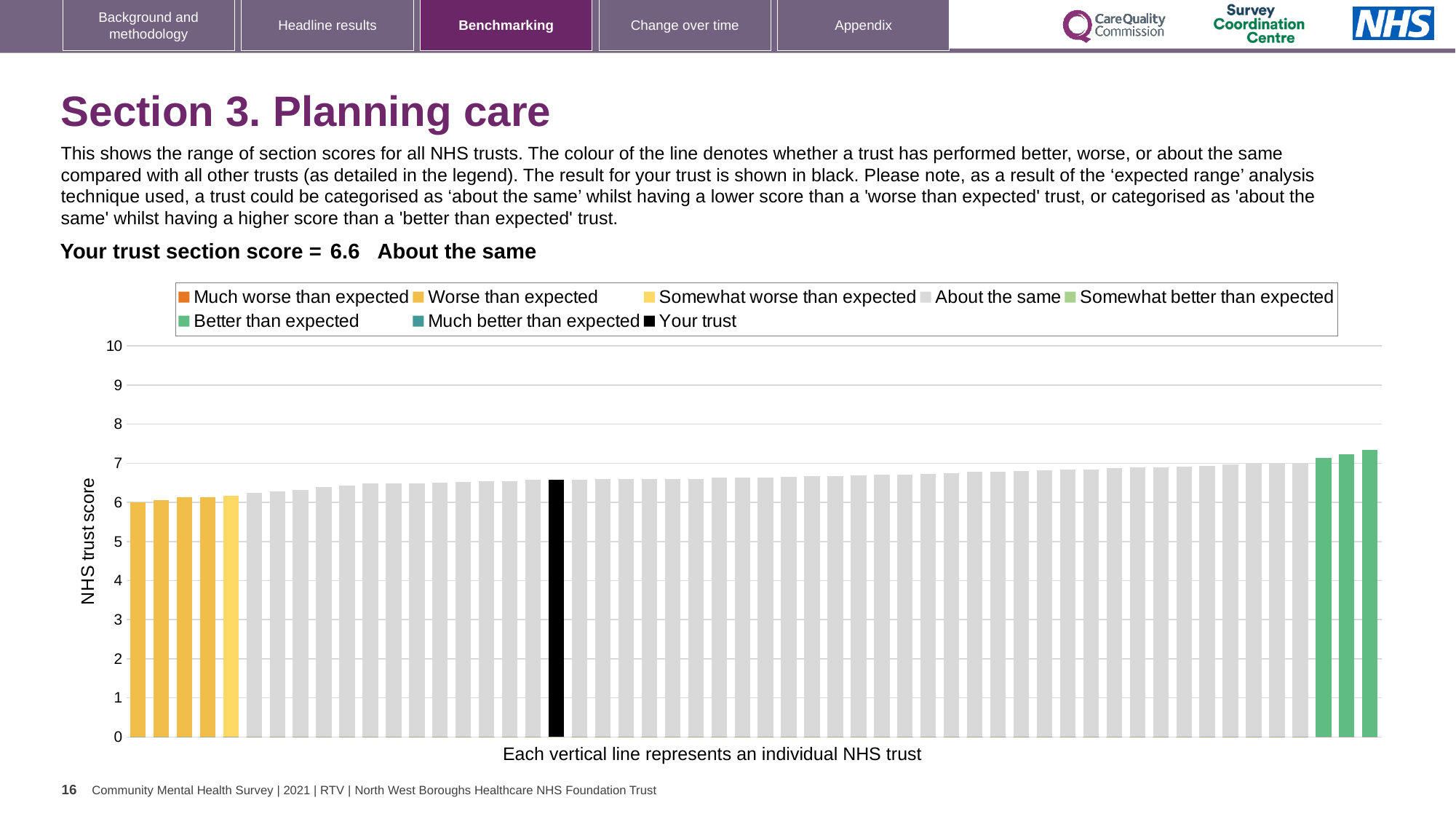
Which performance category is your trust placed in for this section? About the same What is the section score for your trust shown on the slide? 6.6 Is the value for your trust greater or less than 7? less What kind of chart is shown on the slide? bar chart How many entries does the chart legend list? 8 Which is larger: the bar for your trust or the leftmost bar? your trust Do the bar values rise or fall from left to right along the x axis? rise Is the value of the tallest bar (rightmost green bar) greater or less than 7? greater How many bars are coloured green (better than expected)? 3 Is the value for your trust greater or less than 6? greater What colour is the bar representing your trust? black What is the label on the vertical axis of the chart? NHS trust score